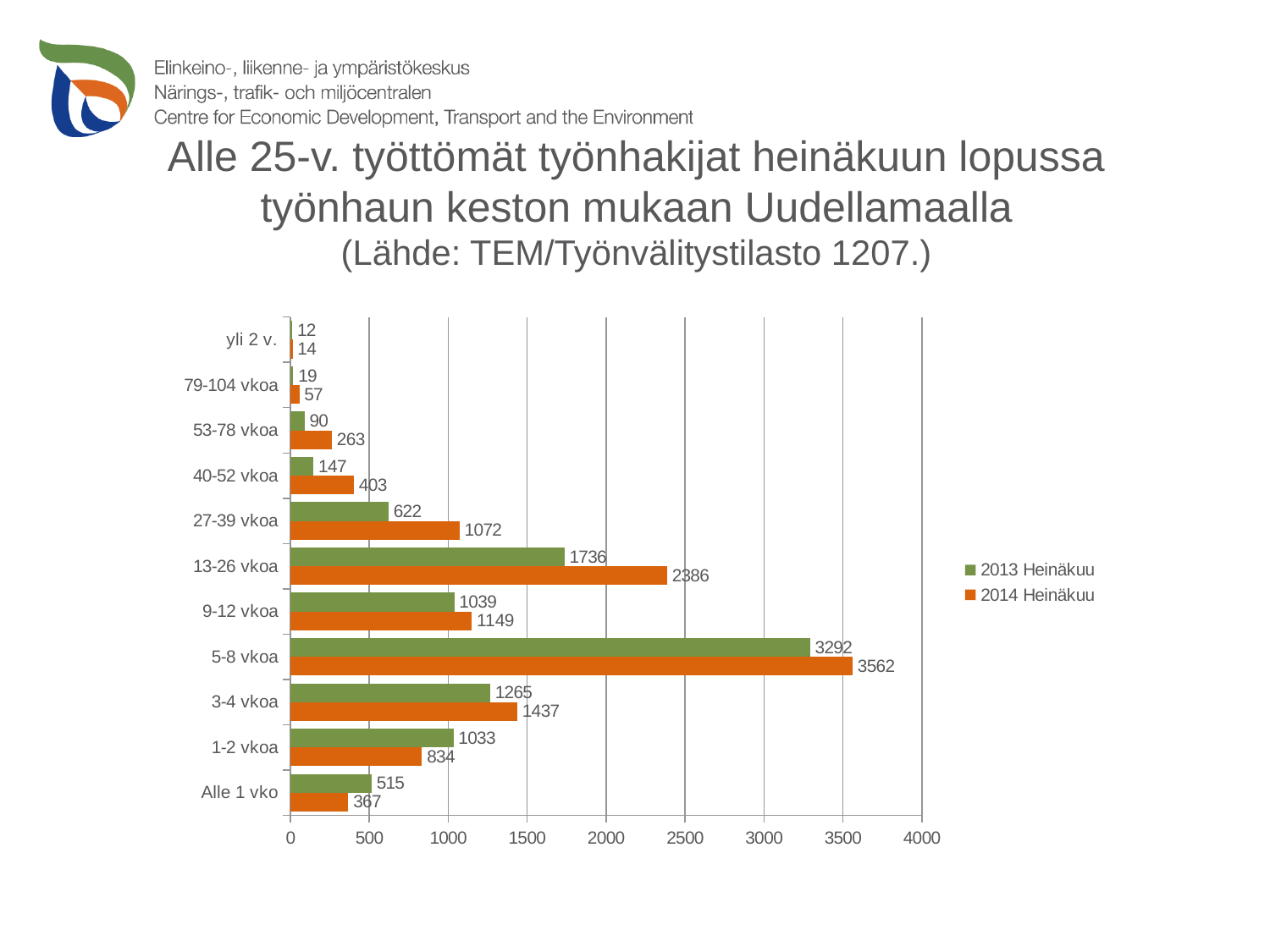
What is the value for 13-26 vkoa in the 2013 Heinäkuu series? 1736 How many categories are shown on the chart? 11 Is the 2014 Heinäkuu value for 13-26 vkoa greater or less than 2000? greater What is the value for Alle 1 vko in the 2014 Heinäkuu series? 367 Which category has the highest value in the 2013 Heinäkuu series? 5-8 vkoa What is the difference between the 2014 Heinäkuu and 2013 Heinäkuu values for 27-39 vkoa? 450 What is the value for 5-8 vkoa in the 2014 Heinäkuu series? 3562 Which category has the lowest value in the 2014 Heinäkuu series? yli 2 v. Which colour represents the 2014 Heinäkuu series? orange How many series does the legend list? 2 What kind of chart is shown on the slide? bar chart Which is larger for 1-2 vkoa: the 2013 Heinäkuu value or the 2014 Heinäkuu value? 2013 Heinäkuu